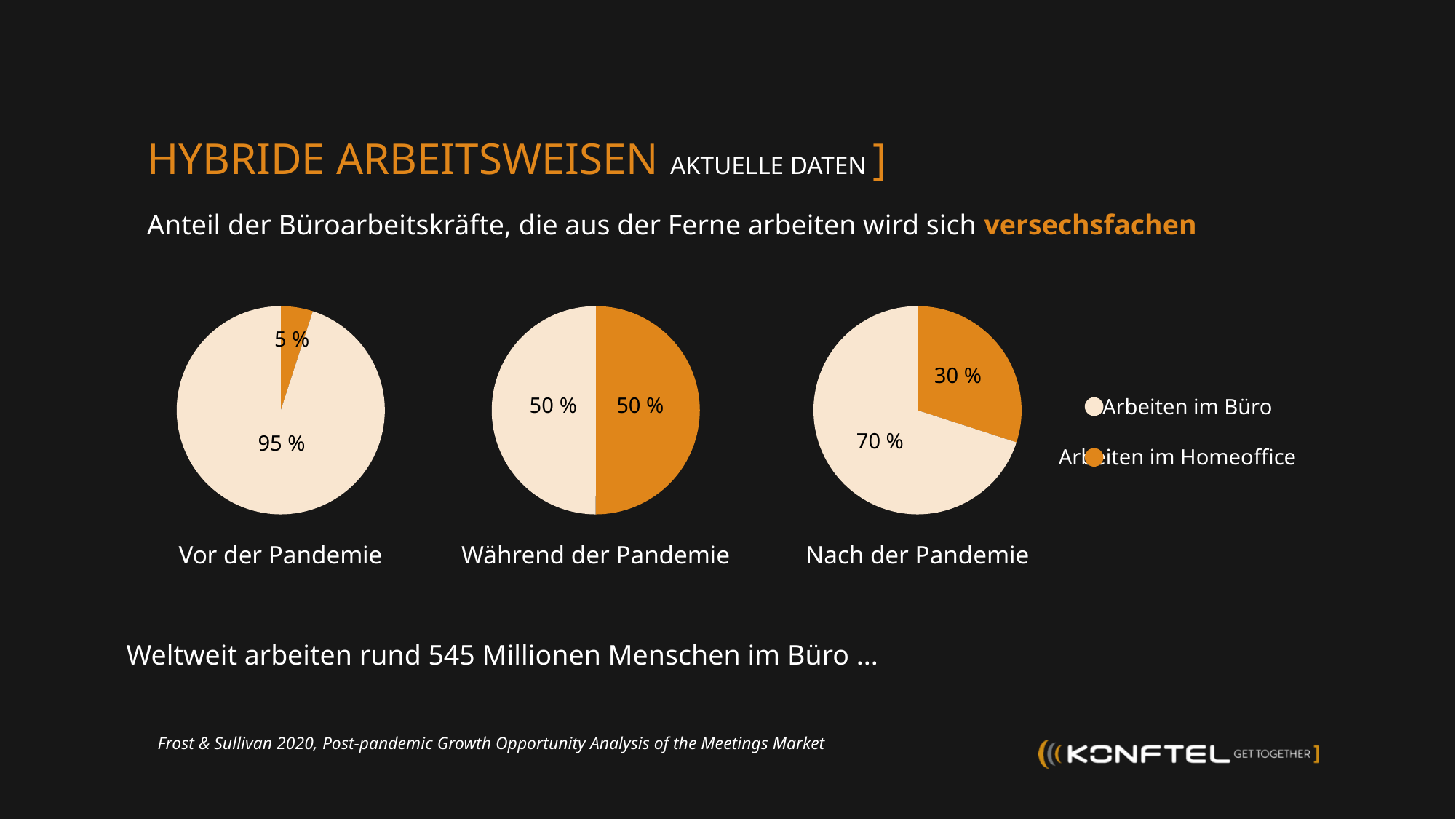
How many entries does the legend list? 2 In the 'Nach der Pandemie' pie chart, what share is 'Arbeiten im Homeoffice'? 30 % Across the three pie charts, which one shows the highest share for 'Arbeiten im Homeoffice'? Während der Pandemie In the 'Nach der Pandemie' pie chart, what is the difference between 'Arbeiten im Büro' and 'Arbeiten im Homeoffice'? 40 % In the 'Nach der Pandemie' pie chart, what share is 'Arbeiten im Büro'? 70 % What type of chart is used on the slide? Pie chart Across the three pie charts, which one shows the lowest share for 'Arbeiten im Büro'? Während der Pandemie In the 'Vor der Pandemie' pie chart, what share is 'Arbeiten im Homeoffice'? 5 % In the 'Vor der Pandemie' pie chart, what share is 'Arbeiten im Büro'? 95 % How many pie charts are shown on the slide? 3 In the 'Vor der Pandemie' pie chart, which slice is larger, 'Arbeiten im Büro' or 'Arbeiten im Homeoffice'? Arbeiten im Büro In the 'Während der Pandemie' pie chart, what share is 'Arbeiten im Homeoffice'? 50 %